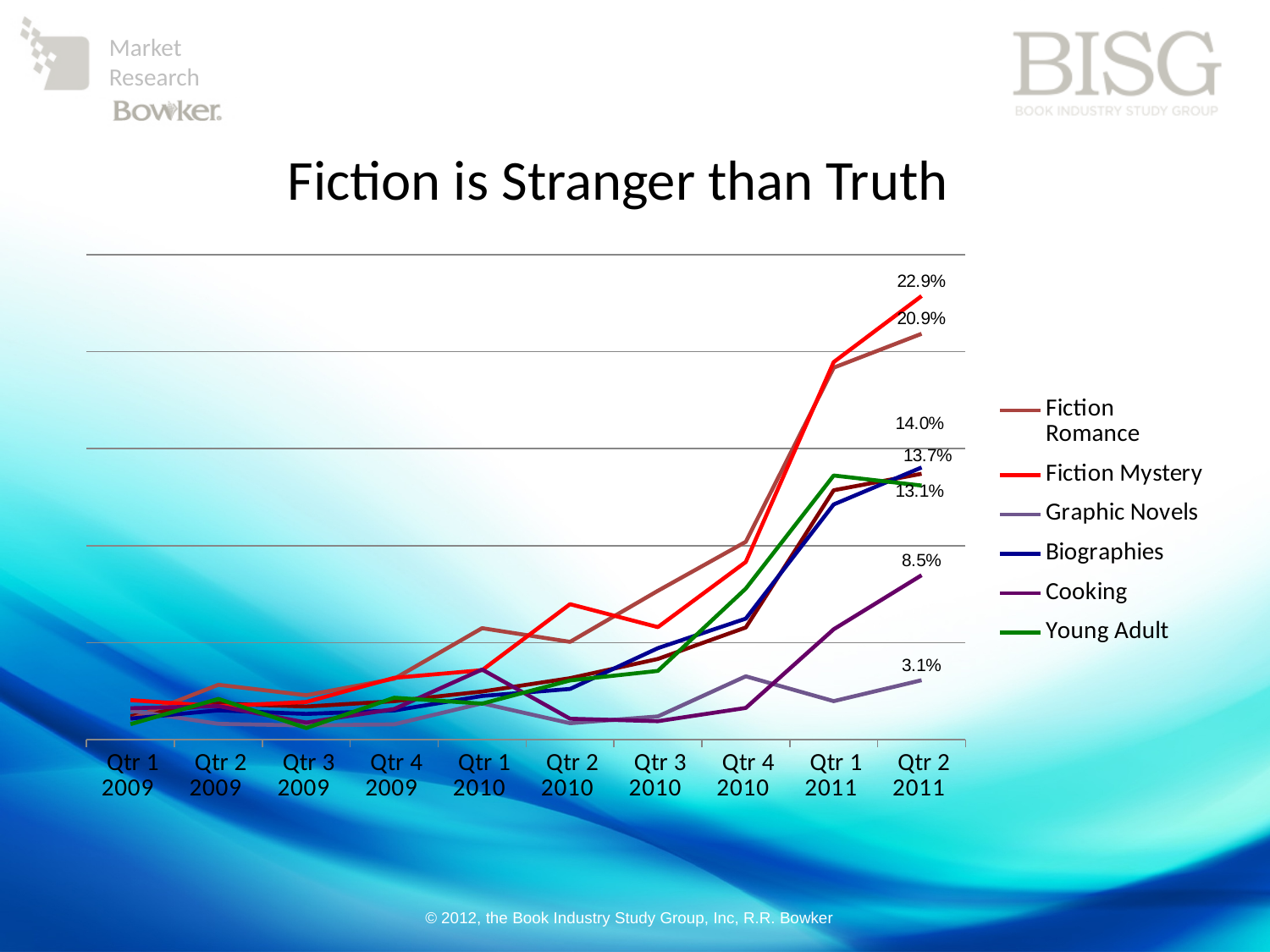
What is the value for Cooking in Qtr 2 2011? 8.5% What is the value for Graphic Novels in Qtr 2 2011? 3.1% Which series has the lowest value in Qtr 2 2011? Graphic Novels How many series does the legend list? 6 In Qtr 2 2011, which is larger: Cooking or Graphic Novels? Cooking What kind of chart is shown on the slide? Line chart Which series has the highest value in Qtr 2 2011? Fiction Mystery What is the value for Fiction Mystery in Qtr 2 2011? 22.9% Does the Fiction Mystery line rise or fall from Qtr 4 2010 to Qtr 2 2011? Rise How many quarters are shown on the x axis? 10 What is the value for Fiction Romance in Qtr 2 2011? 20.9% What is the difference between Fiction Mystery and Fiction Romance in Qtr 2 2011? 2.0%